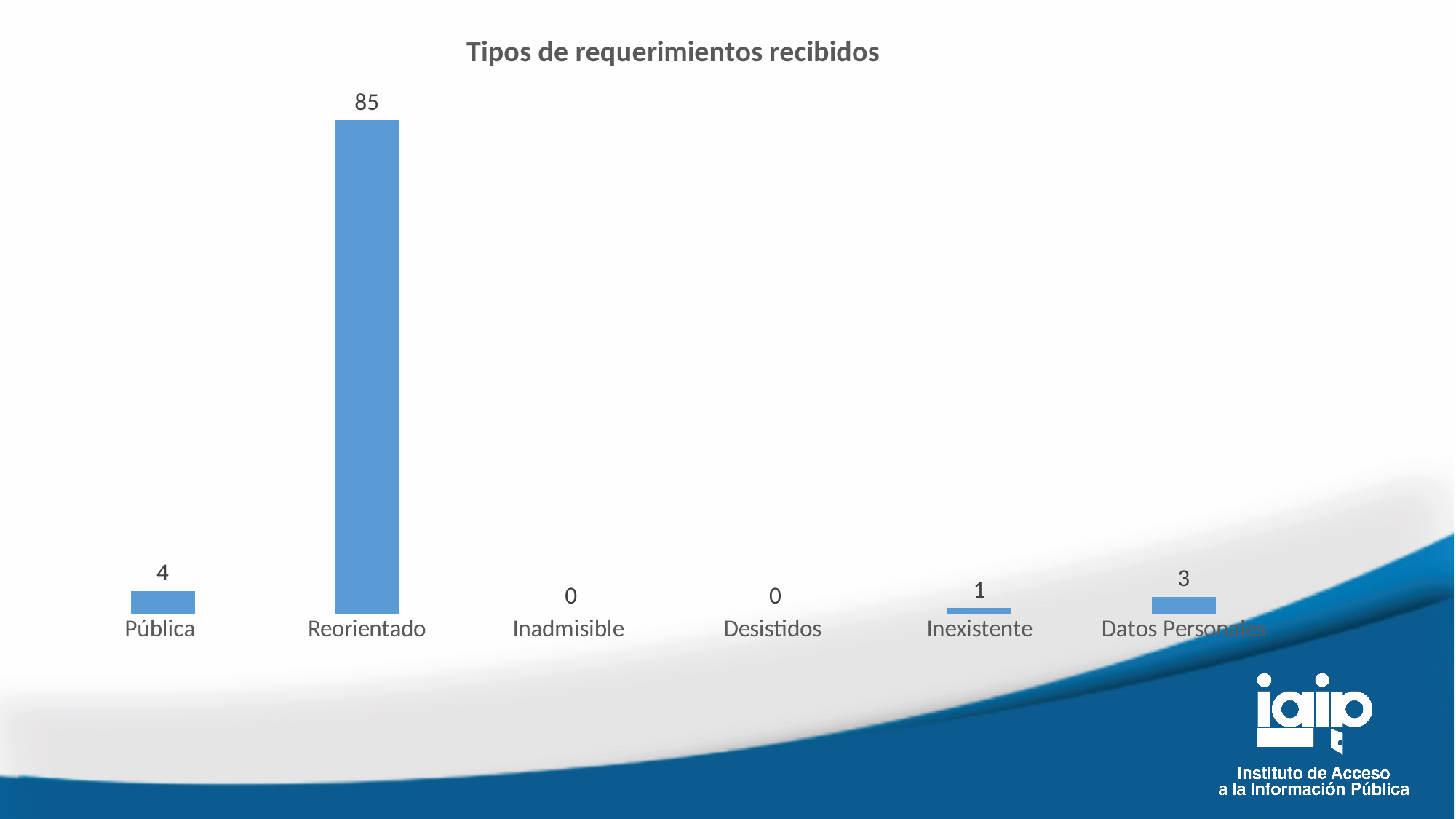
What kind of chart is shown on the slide? Bar chart What is the difference between the values for Pública and Datos Personales? 1 What is the value for Inadmisible? 0 What is the value for Datos Personales? 3 How many categories are shown on the x axis? 6 What is the difference between the values for Reorientado and Pública? 81 What is the title of the chart? Tipos de requerimientos recibidos Which category has the highest value? Reorientado Which is larger, the value for Pública or the value for Inexistente? Pública What is the value for Inexistente? 1 What is the value for Reorientado? 85 What is the value for Pública? 4